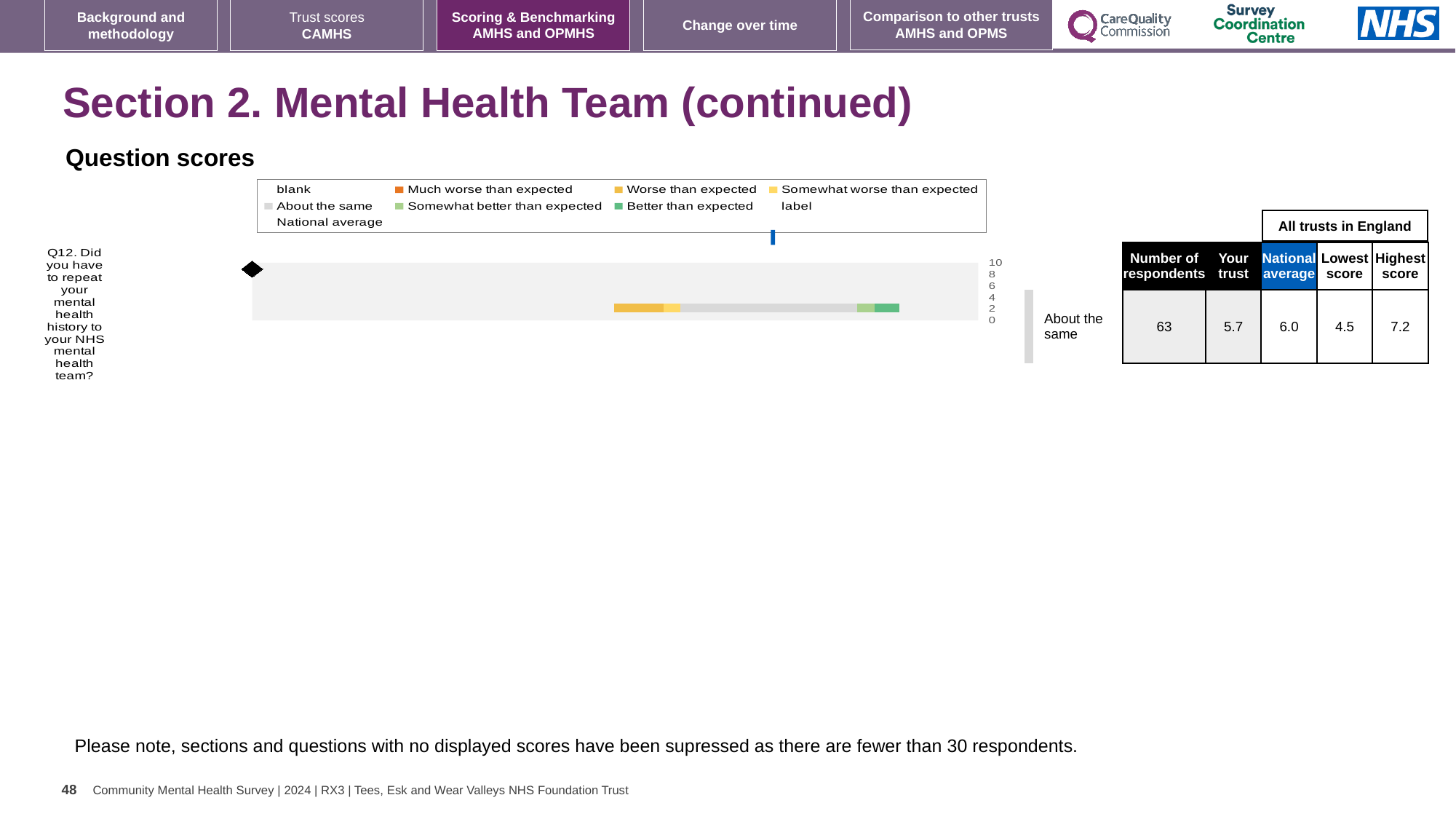
What is the National average score for Q12? 6.0 What is the difference between the National average and the 'Your trust' score for Q12? 0.3 Which question is plotted in the Question scores chart? Q12. Did you have to repeat your mental health history to your NHS mental health team? What kind of chart is shown under 'Question scores'? bar chart Which benchmark category is the trust's Q12 score placed in? About the same Which is larger for Q12, the 'Your trust' score or the National average? National average What is the Lowest score among all trusts in England for Q12? 4.5 How many questions are plotted in the Question scores chart? 1 How many respondents answered Q12? 63 What is the difference between the Highest score and the Lowest score for Q12? 2.7 What is the Highest score among all trusts in England for Q12? 7.2 What is the 'Your trust' score for Q12? 5.7